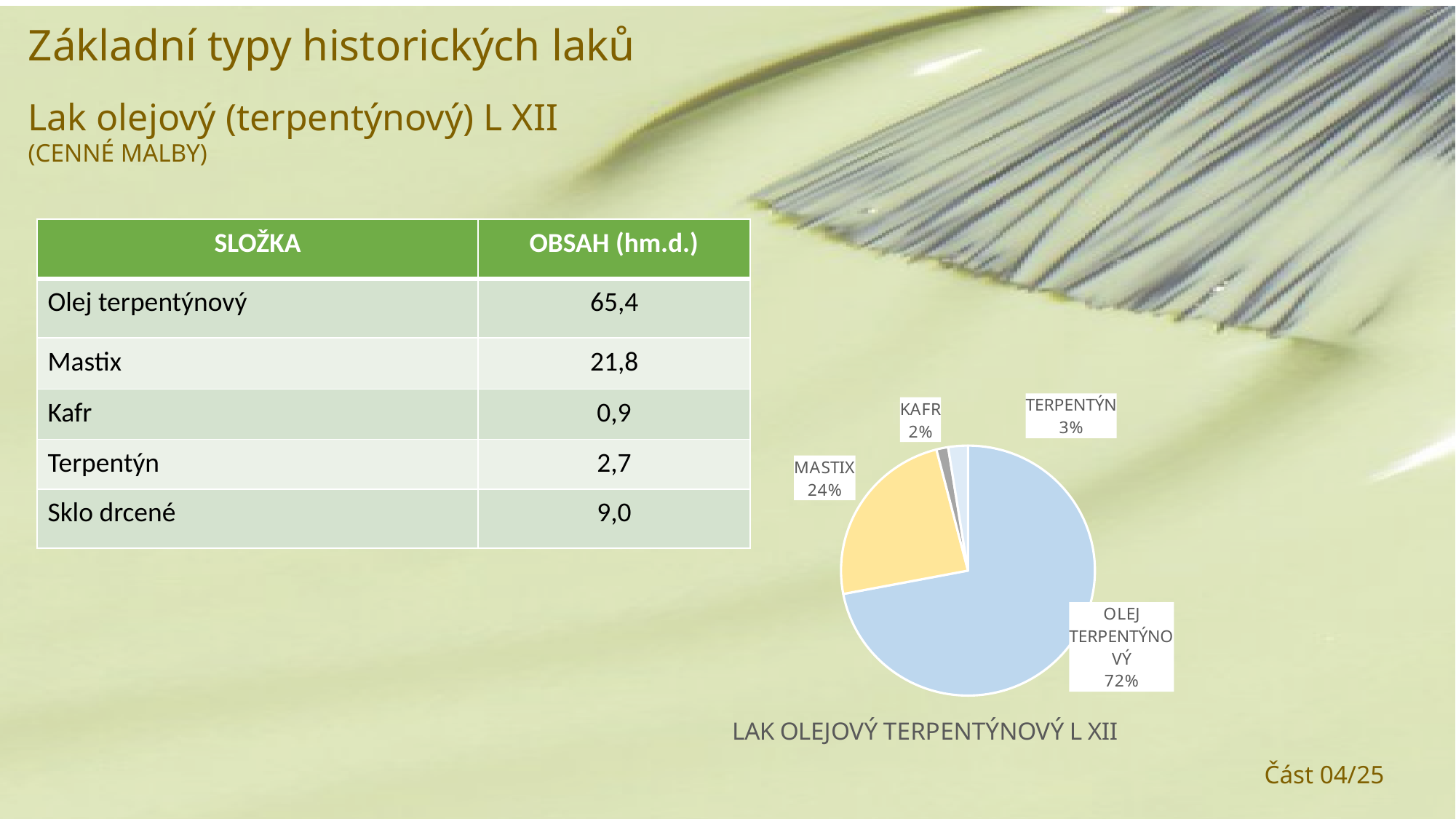
Which slice of the pie chart is the largest? OLEJ TERPENTÝNOVÝ What type of chart is shown on the slide? pie chart What colour is the MASTIX slice in the pie chart? yellow Which is larger in the pie chart, MASTIX or TERPENTÝN? MASTIX What share of the pie does KAFR have? 2% How many slices does the pie chart have? 4 What share of the pie does MASTIX have? 24% What is the title of the pie chart? LAK OLEJOVÝ TERPENTÝNOVÝ L XII Which slice of the pie chart is the smallest? KAFR What share of the pie does OLEJ TERPENTÝNOVÝ have? 72% How many percentage points larger is the OLEJ TERPENTÝNOVÝ slice than the MASTIX slice? 48